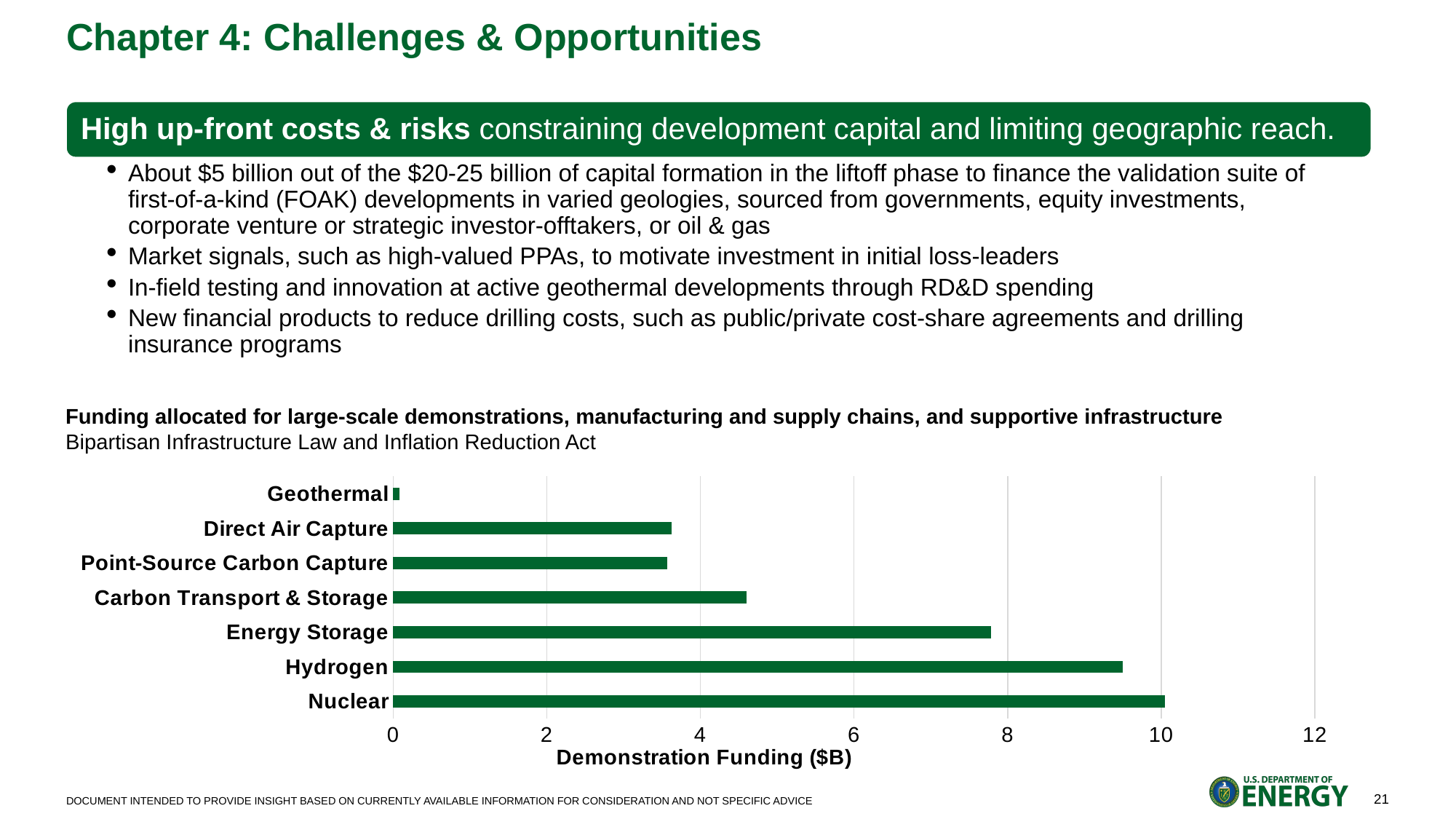
Is the value for Energy Storage greater or less than 8? less Is the value for Direct Air Capture greater or less than 4? less Is the value for Carbon Transport & Storage greater or less than 4? greater What is the label of the x axis of the chart? Demonstration Funding ($B) Which category has the lowest demonstration funding? Geothermal Which has more demonstration funding, Energy Storage or Carbon Transport & Storage? Energy Storage What kind of chart is shown on the slide? bar chart Which has more demonstration funding, Hydrogen or Energy Storage? Hydrogen Which has more demonstration funding, Nuclear or Hydrogen? Nuclear Which category has the highest demonstration funding? Nuclear How many categories are plotted in the bar chart? 7